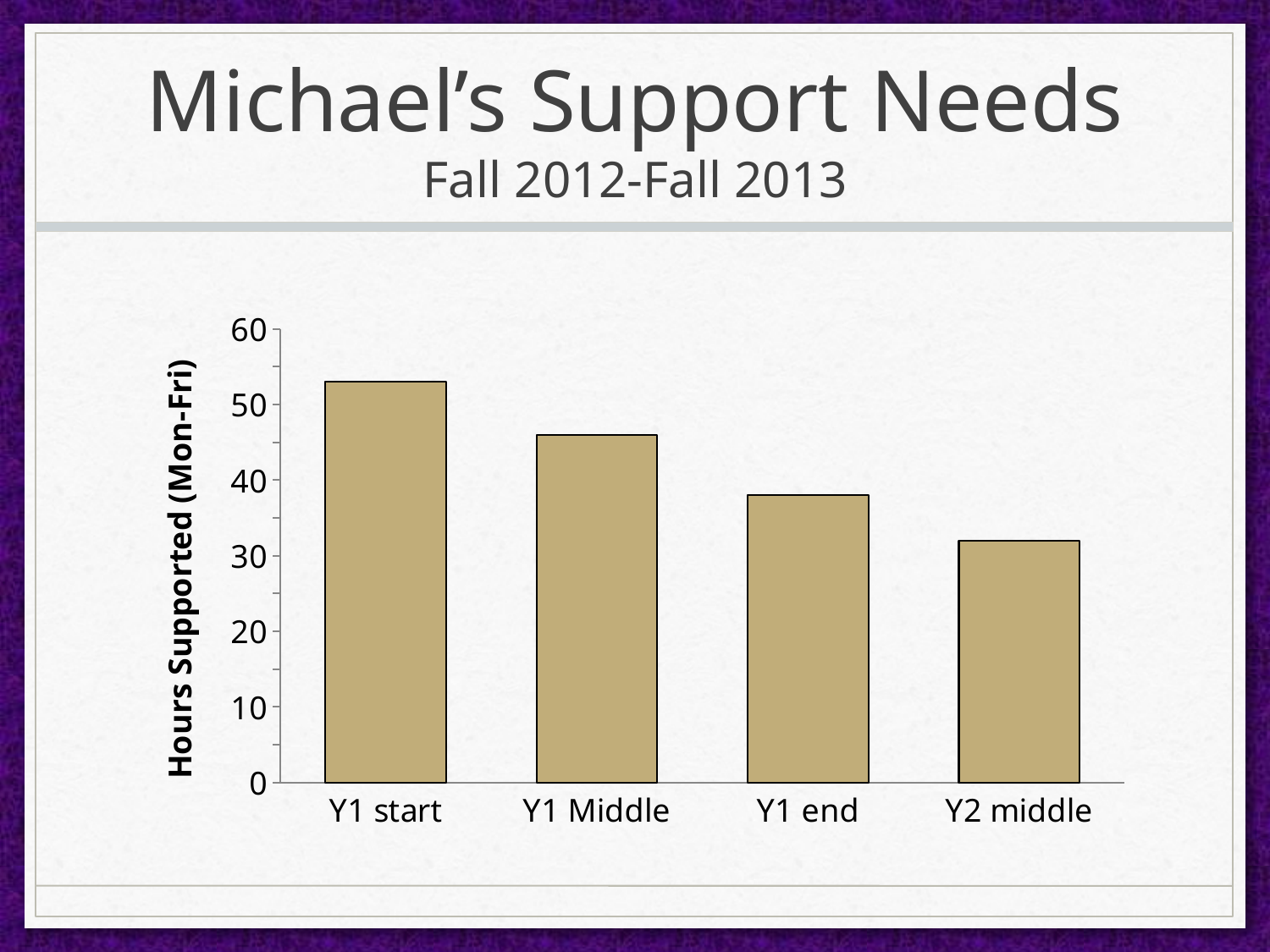
How many categories are shown on the x axis of the chart? 4 Is the value for Y1 start greater or less than 50? greater Is the value for Y1 end greater or less than 40? less Do the values rise or fall from Y1 start to Y2 middle? fall Which category has the highest value in the chart? Y1 start Which category has the lowest value in the chart? Y2 middle Is the value for Y2 middle greater or less than 30? greater What is the label of the vertical axis of the chart? Hours Supported (Mon-Fri) What is the title of the slide containing the chart? Michael's Support Needs Fall 2012-Fall 2013 What kind of chart is shown on the slide? bar chart Which is larger, the value for Y1 Middle or the value for Y1 end? Y1 Middle